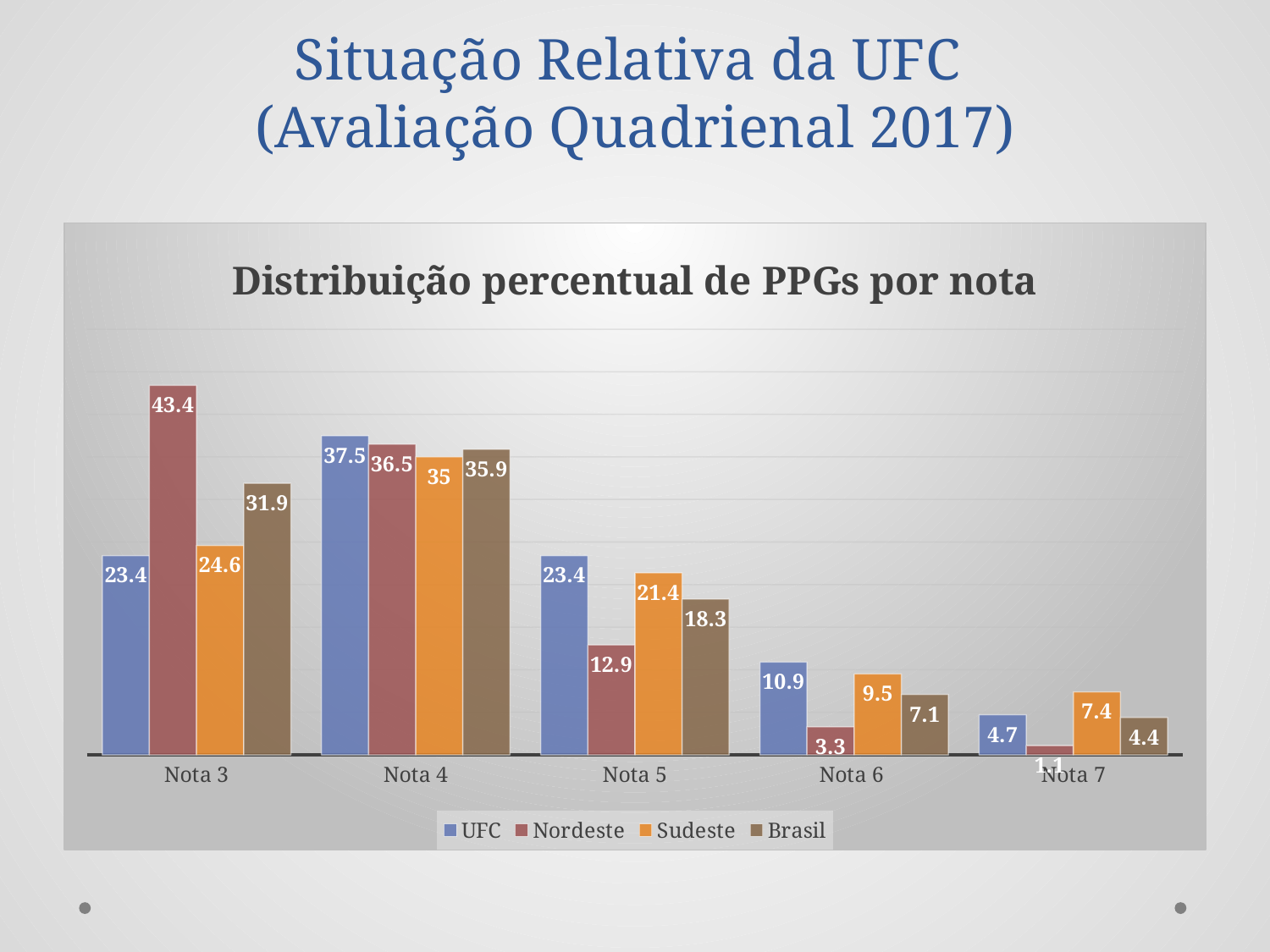
Which category has the lowest value for the UFC series? Nota 7 What kind of chart is shown on the slide? Bar chart Which is larger at Nota 6: the UFC value or the Sudeste value? UFC Which category has the highest value for the Nordeste series? Nota 3 What is the value for UFC at Nota 4? 37.5 How many series does the legend list? 4 What is the value for Brasil at Nota 5? 18.3 What is the value for Sudeste at Nota 7? 7.4 What is the value for Nordeste at Nota 3? 43.4 What is the difference between the UFC and Nordeste values at Nota 5? 10.5 How many categories are shown on the x axis? 5 What is the title of the chart? Distribuição percentual de PPGs por nota